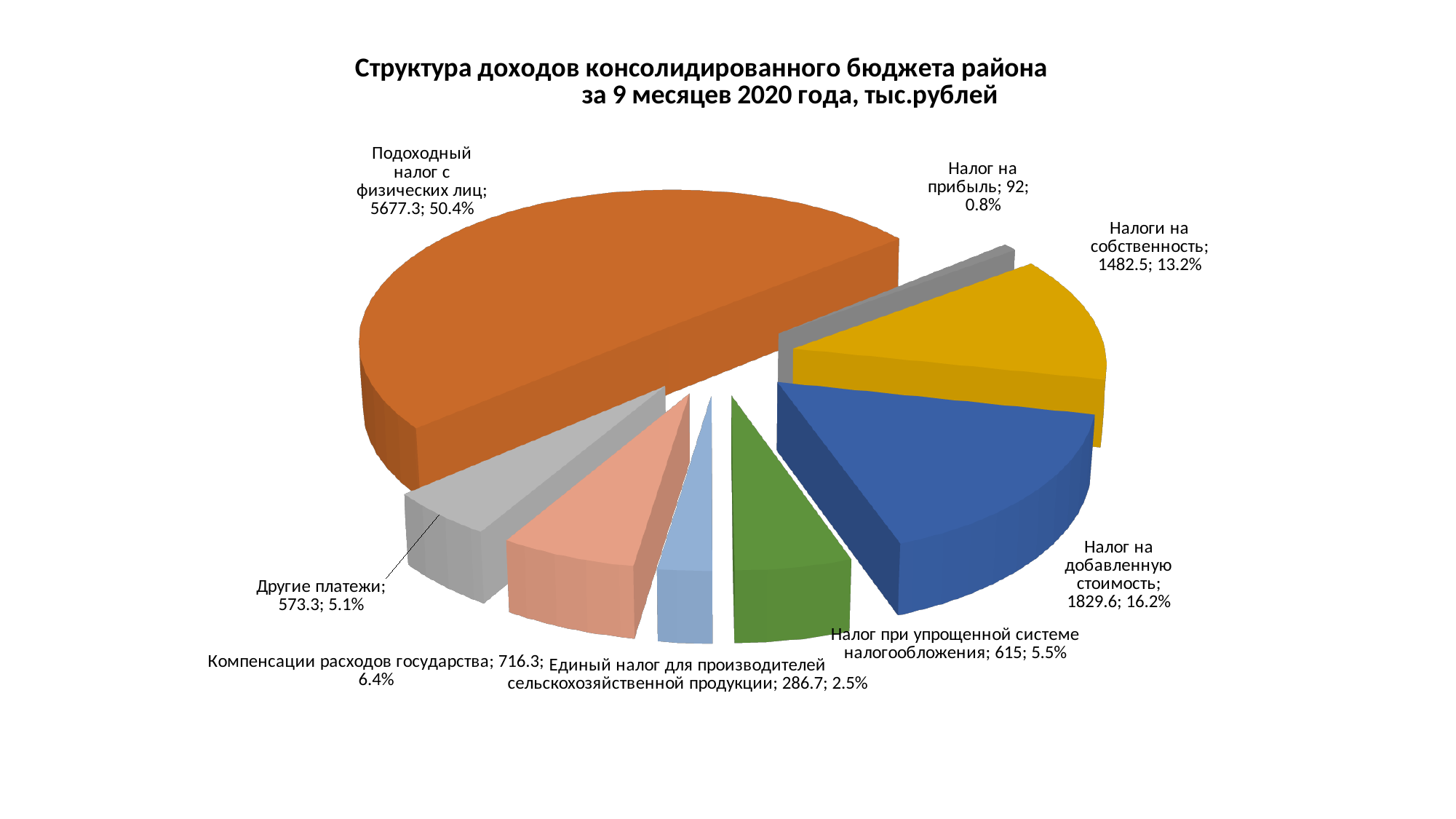
What share of the pie does Налоги на собственность represent? 13.2% What is the value for Налог на прибыль? 92 What is the value for Налог на добавленную стоимость? 1829.6 How many slices does the pie chart have? 8 What kind of chart is shown on the slide? pie chart What is the title of the chart? Структура доходов консолидированного бюджета района за 9 месяцев 2020 года, тыс.рублей What is the value for Единый налог для производителей сельскохозяйственной продукции? 286.7 What is the difference between the values for Налог на добавленную стоимость and Налоги на собственность? 347.1 Which is larger: Компенсации расходов государства or Налог при упрощенной системе налогообложения? Компенсации расходов государства Which category has the smallest slice of the pie? Налог на прибыль What is the value for Подоходный налог с физических лиц? 5677.3 Which category has the largest slice of the pie? Подоходный налог с физических лиц